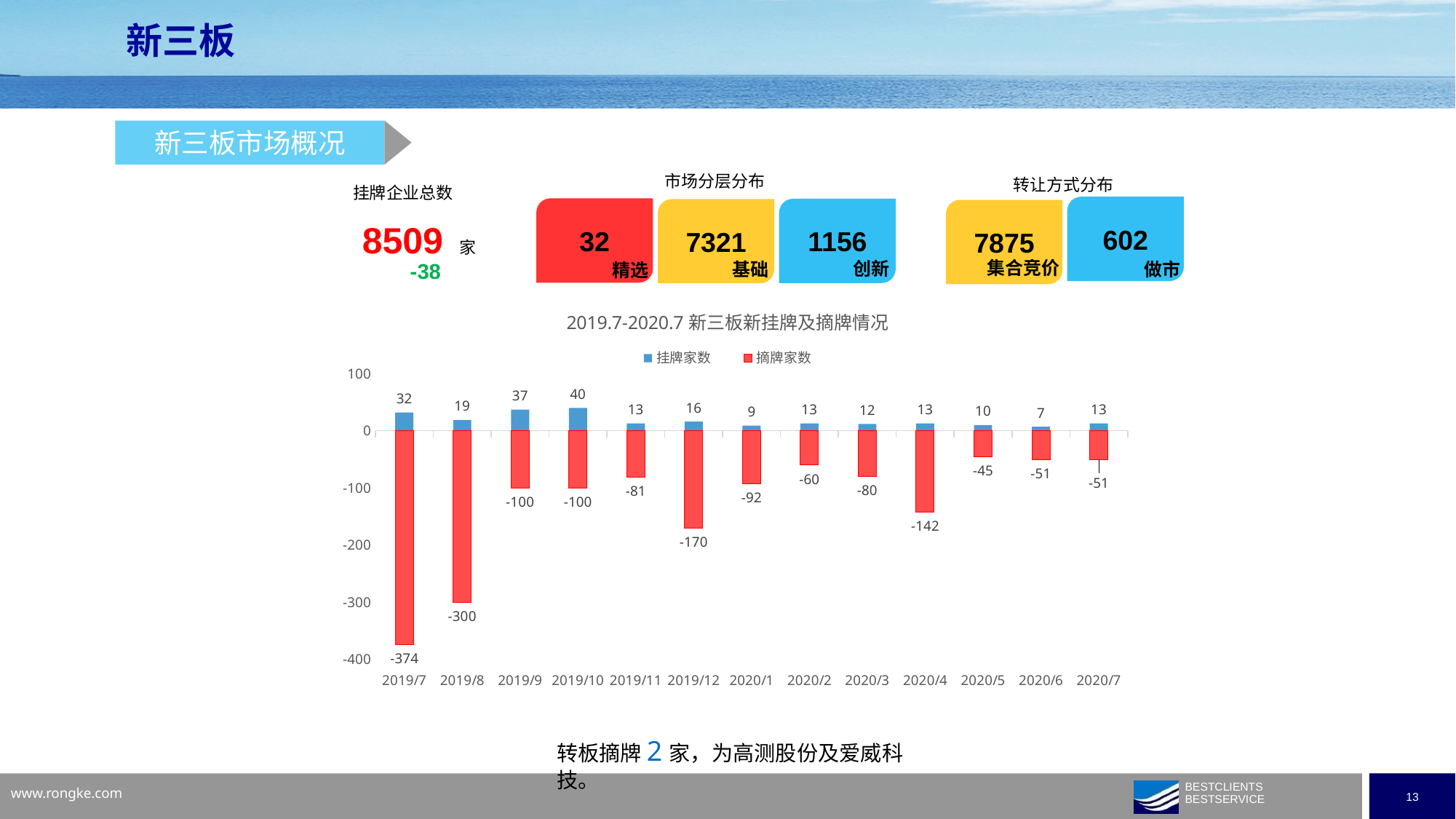
Which series is shown in red in the chart's legend? 摘牌家数 How many months (categories) are shown on the x axis of the chart? 13 Is the 挂牌家数 value for 2019/7 larger or smaller than the value for 2019/11? larger What is the difference between the 挂牌家数 values for 2019/9 and 2019/8? 18 What is the 摘牌家数 value for 2020/4? -142 What is the 摘牌家数 value for 2019/12? -170 What type of chart is shown under the title "2019.7-2020.7 新三板新挂牌及摘牌情况"? bar chart Which month has the lowest 挂牌家数 value? 2020/6 How many series does the legend of the chart list? 2 Which month has the most negative 摘牌家数 value? 2019/7 What is the 挂牌家数 value for 2019/10? 40 Which month has the highest 挂牌家数 value? 2019/10